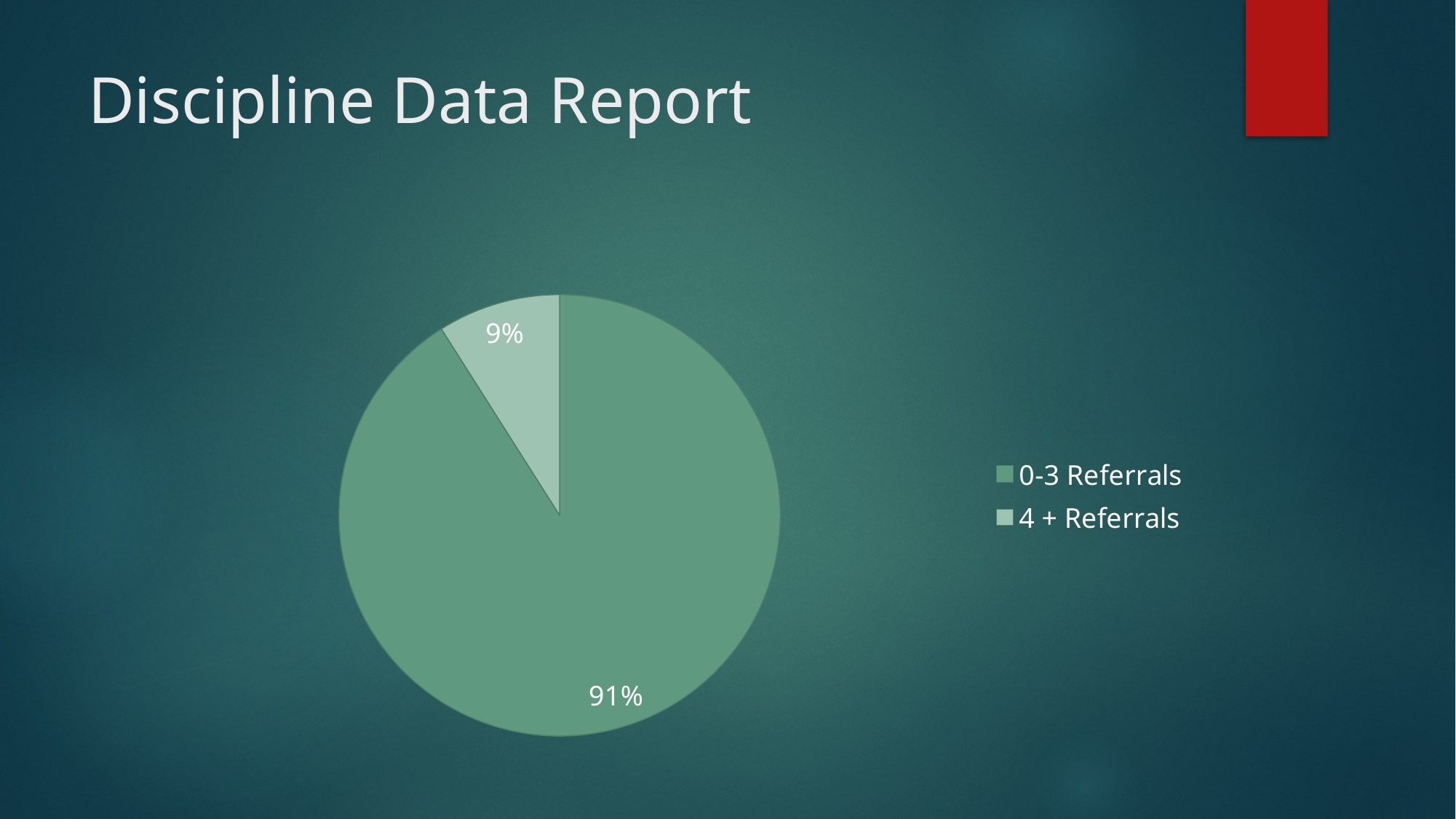
What kind of chart is shown on the slide? pie chart What percentage of the pie is labelled for 4 + Referrals? 9% Which legend entry is shown in the lighter green colour? 4 + Referrals How many slices does the pie chart have? 2 How many entries does the legend list? 2 Which category has the smallest slice of the pie? 4 + Referrals What percentage of the pie is labelled for 0-3 Referrals? 91% What is the difference in percentage points between the 0-3 Referrals slice and the 4 + Referrals slice? 82 What share of the pie does the 4 + Referrals slice represent? 9% Which slice is larger, 0-3 Referrals or 4 + Referrals? 0-3 Referrals Which category has the largest slice of the pie? 0-3 Referrals What is the title of the slide containing the pie chart? Discipline Data Report